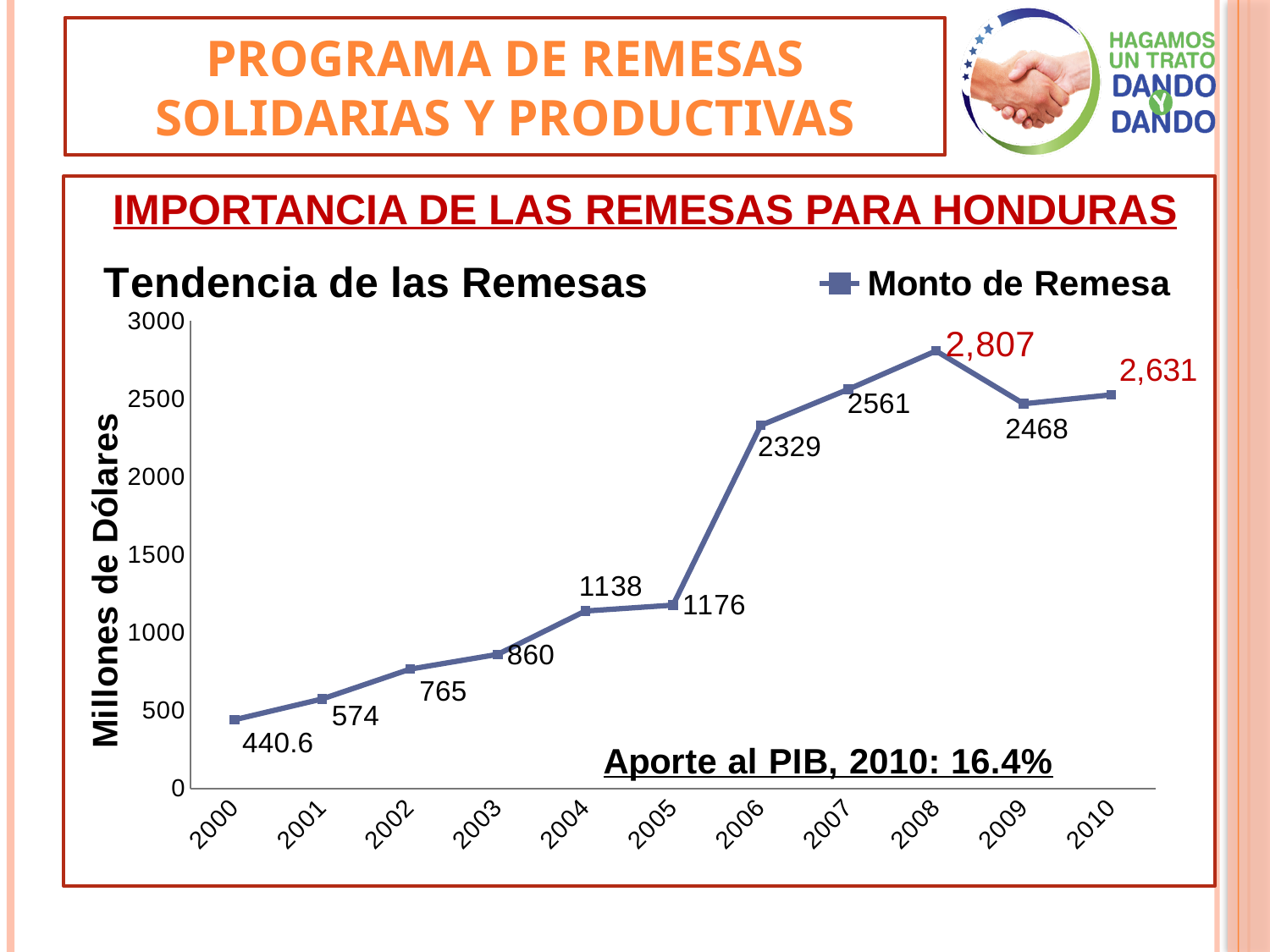
What is the difference between the values for 2008 and 2009 in the Tendencia de las Remesas chart? 339 What kind of chart is Tendencia de las Remesas? line chart How many series does the legend of the Tendencia de las Remesas chart list? 1 What is the y-axis label of the Tendencia de las Remesas chart? Millones de Dólares What is the value for 2006 in the Tendencia de las Remesas chart? 2329 What is the value for 2010 in the Tendencia de las Remesas chart? 2,631 Is the value for 2007 in the Tendencia de las Remesas chart greater or less than 2500? greater How many years are plotted on the x axis of the Tendencia de las Remesas chart? 11 What is the value for 2000 in the Tendencia de las Remesas chart? 440.6 Which year has the highest value in the Tendencia de las Remesas chart? 2008 Which is larger in the Tendencia de las Remesas chart, the value for 2004 or the value for 2005? 2005 Which year has the lowest value in the Tendencia de las Remesas chart? 2000